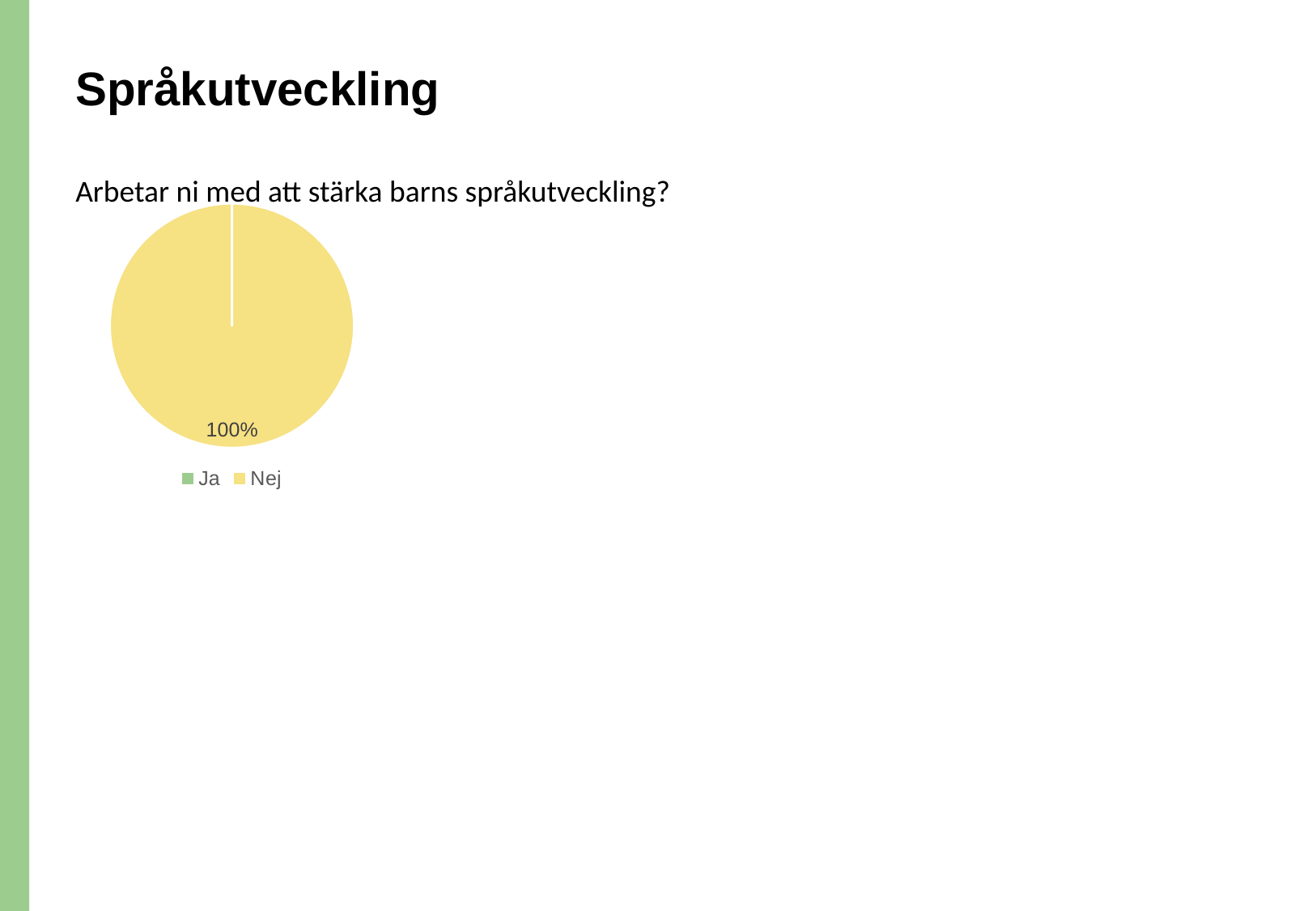
What kind of chart is shown on the slide? pie chart Which category has the largest slice of the pie chart? Nej How many entries does the legend of the pie chart list? 2 Is the share for Nej greater or less than 50%? greater How many categories are listed in the legend of the pie chart? 2 What are the two legend entries of the pie chart? Ja and Nej What colour represents Nej in the pie chart? yellow What share of the pie does the Nej slice take up? 100% Which is larger in the pie chart, Ja or Nej? Nej What percentage is printed on the pie chart? 100%